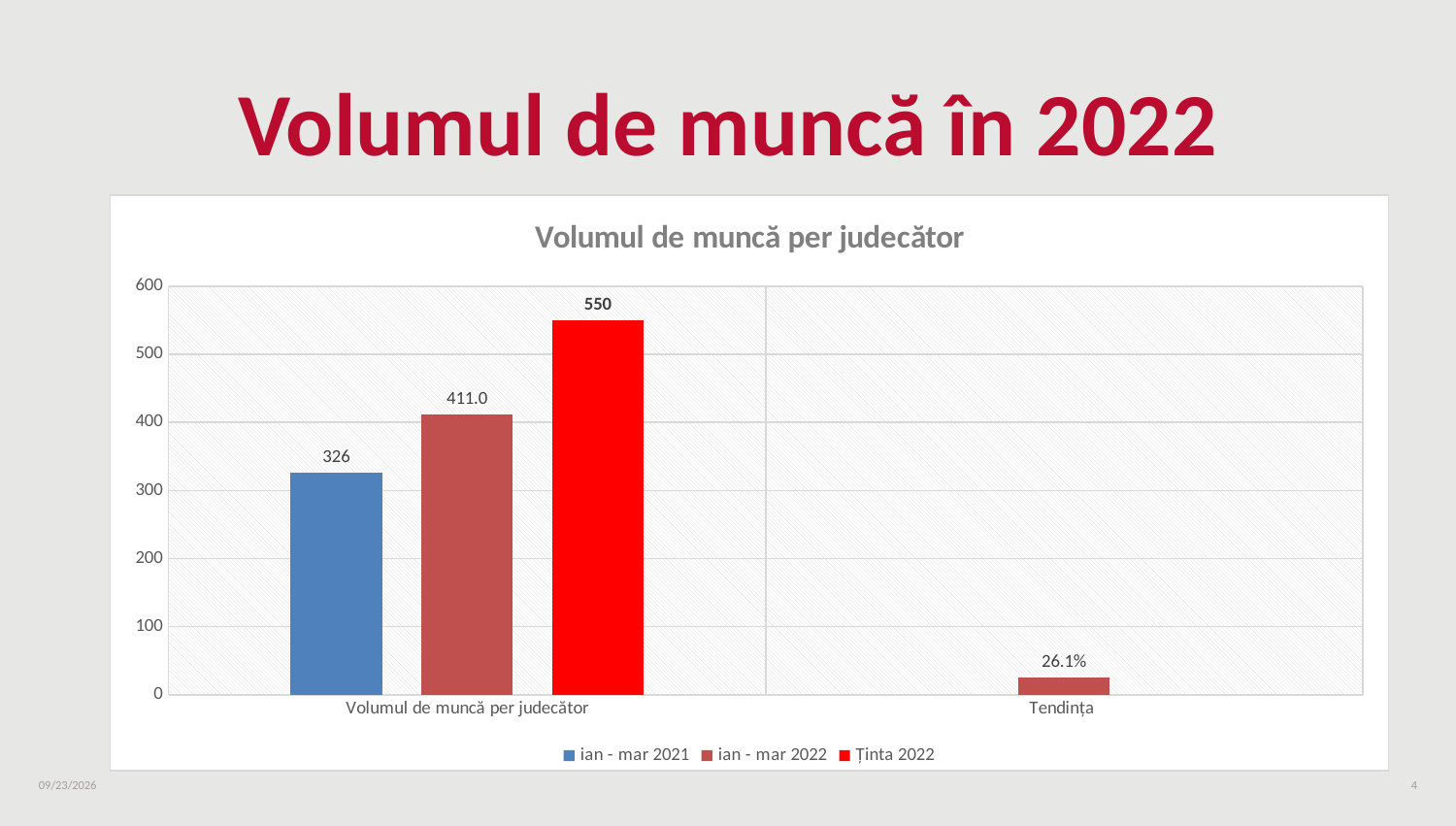
What is the difference between the Ținta 2022 value and the ian - mar 2022 value in the Volumul de muncă per judecător category? 139 How many series does the legend list? 3 How many categories are shown on the x axis? 2 What type of chart is shown on the slide? bar chart What is the value shown for the Tendința category? 26.1% What is the value for Ținta 2022 in the Volumul de muncă per judecător category? 550 Which series has the lowest value in the Volumul de muncă per judecător category? ian - mar 2021 What is the value for ian - mar 2021 in the Volumul de muncă per judecător category? 326 What is the title of the chart? Volumul de muncă per judecător Which series has the highest value in the Volumul de muncă per judecător category? Ținta 2022 What is the value for ian - mar 2022 in the Volumul de muncă per judecător category? 411.0 Which is larger in the Volumul de muncă per judecător category: ian - mar 2021 or ian - mar 2022? ian - mar 2022